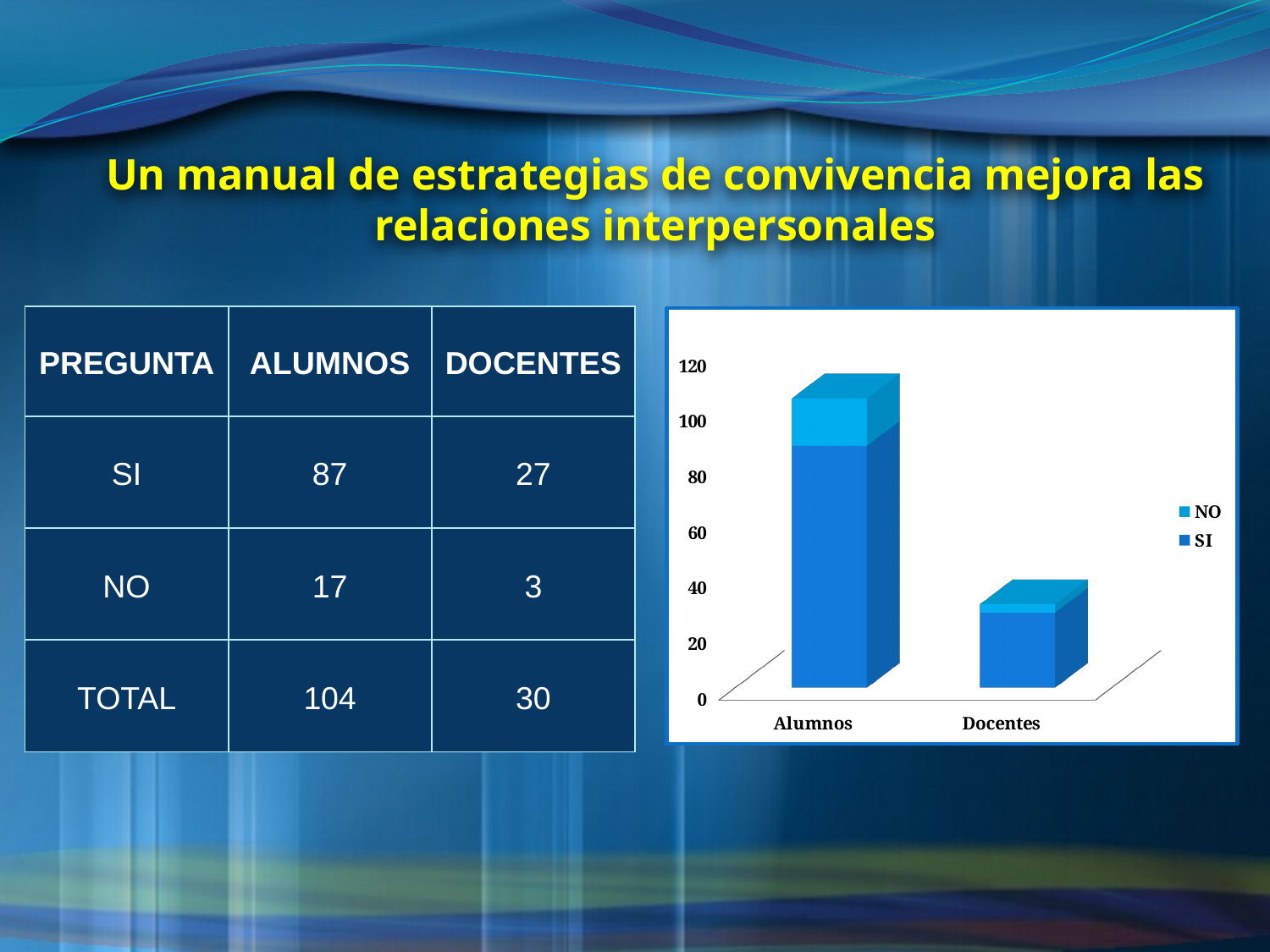
What is the total of the stacked bar for Alumnos? 104 Is the total height of the Alumnos bar greater or less than 100? greater What are the two entries in the chart legend? NO and SI Is the total height of the Docentes bar greater or less than 40? less According to the slide, what is the NO value for Docentes? 3 Which category has the taller stacked bar, Alumnos or Docentes? Alumnos How many series does the chart legend list? 2 What is the difference between the SI value for Alumnos and the SI value for Docentes? 60 What kind of chart is shown on the slide? Stacked bar chart How many categories are shown on the x axis of the chart? 2 For Alumnos, which is larger, the SI segment or the NO segment? SI According to the slide, what is the SI value for Alumnos? 87